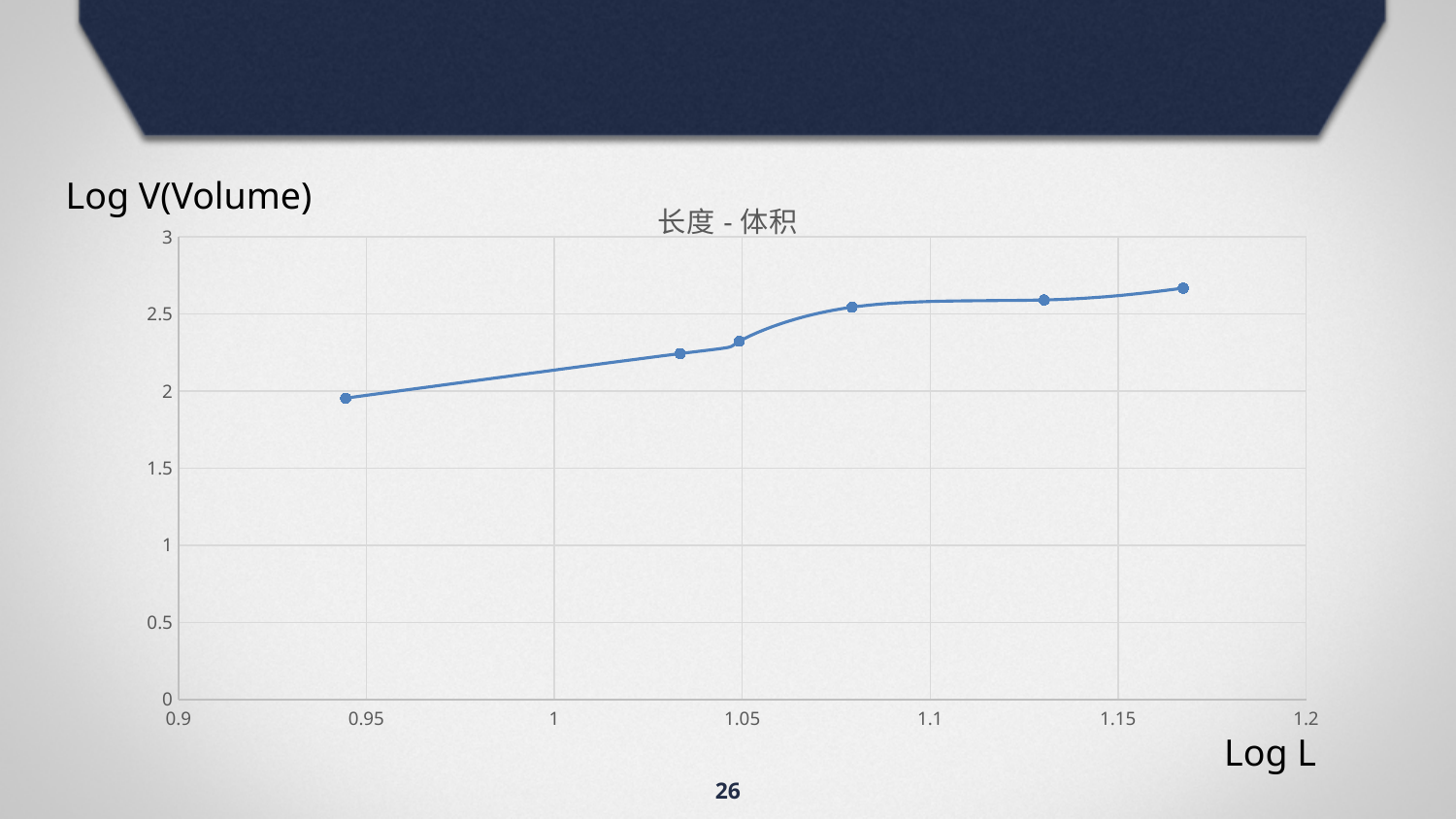
Is the Log V value of the rightmost data point greater or less than 3? less Which data point has the highest Log V value, the leftmost or the rightmost? rightmost Do the plotted values rise or fall as Log L increases along the x axis? rise Which is larger, the Log V value at the leftmost point or at the point near Log L = 1.08? the point near Log L = 1.08 Is the Log V value of the rightmost data point greater or less than 2.5? greater Is the Log V value of the data point near Log L = 1.05 greater or less than 2? greater What kind of chart is shown on the slide? line chart What is the title of the chart? 长度 - 体积 Which data point has the lowest Log V value, the leftmost or the rightmost? leftmost What label is shown for the vertical axis of the chart? Log V(Volume) How many data points are plotted on the line? 6